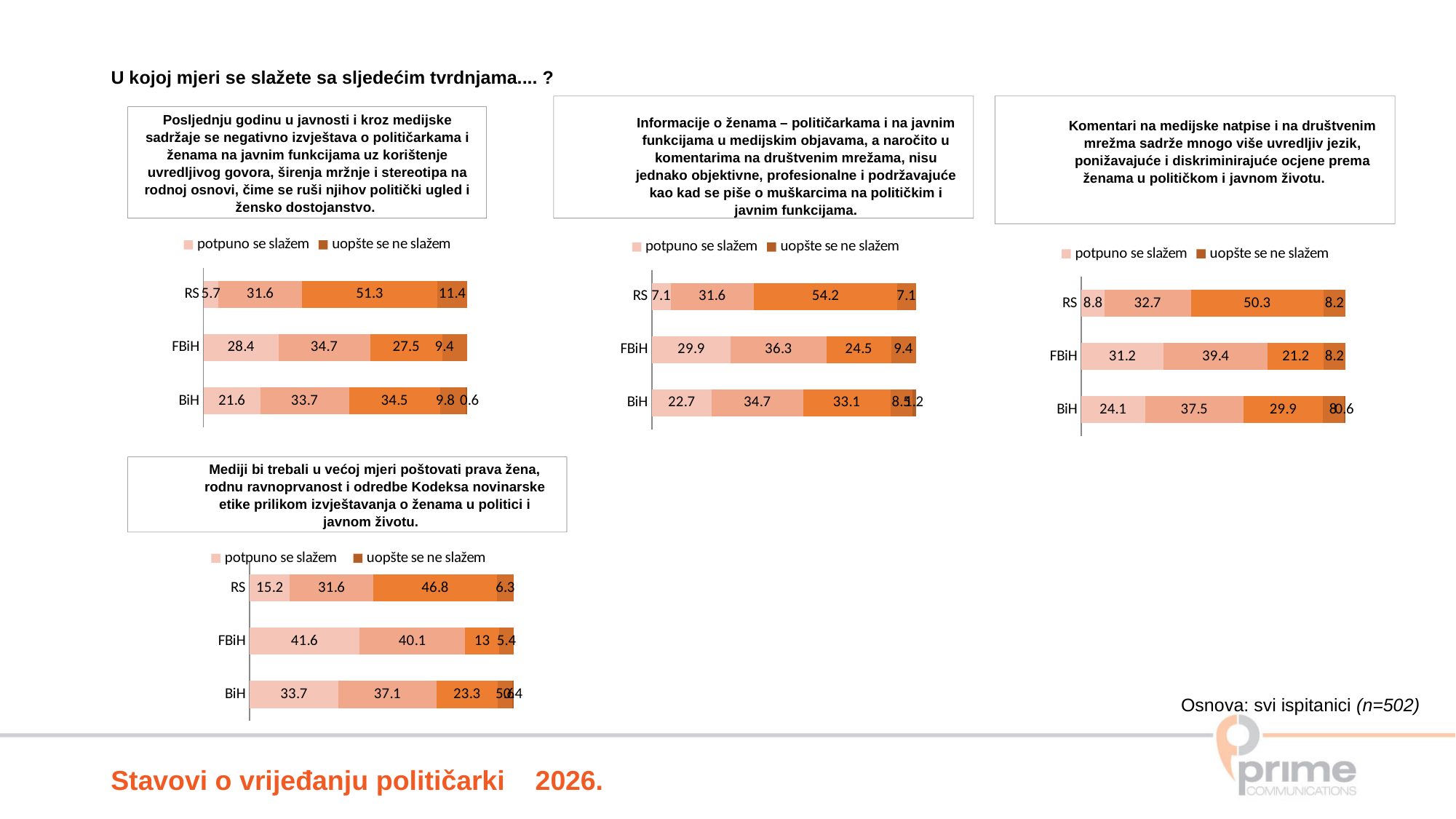
In the top-middle chart, what is the value for 'potpuno se slažem' for RS? 7.1 In the top-right chart, what is the value for 'potpuno se slažem' for FBiH? 31.2 In the top-left chart, what is the total of the stacked bar for RS? 100.0 In the top-right chart, what is the difference between the 'potpuno se slažem' values for FBiH and RS? 22.4 In the top-left chart, what is the value for 'potpuno se slažem' for FBiH? 28.4 In the bottom-left chart, which category has the highest value for 'potpuno se slažem'? FBiH What kind of chart is the bottom-left chart? Stacked bar chart How many categories are shown on the y axis of the top-right chart? 3 In the bottom-left chart, what is the value for 'potpuno se slažem' for FBiH? 41.6